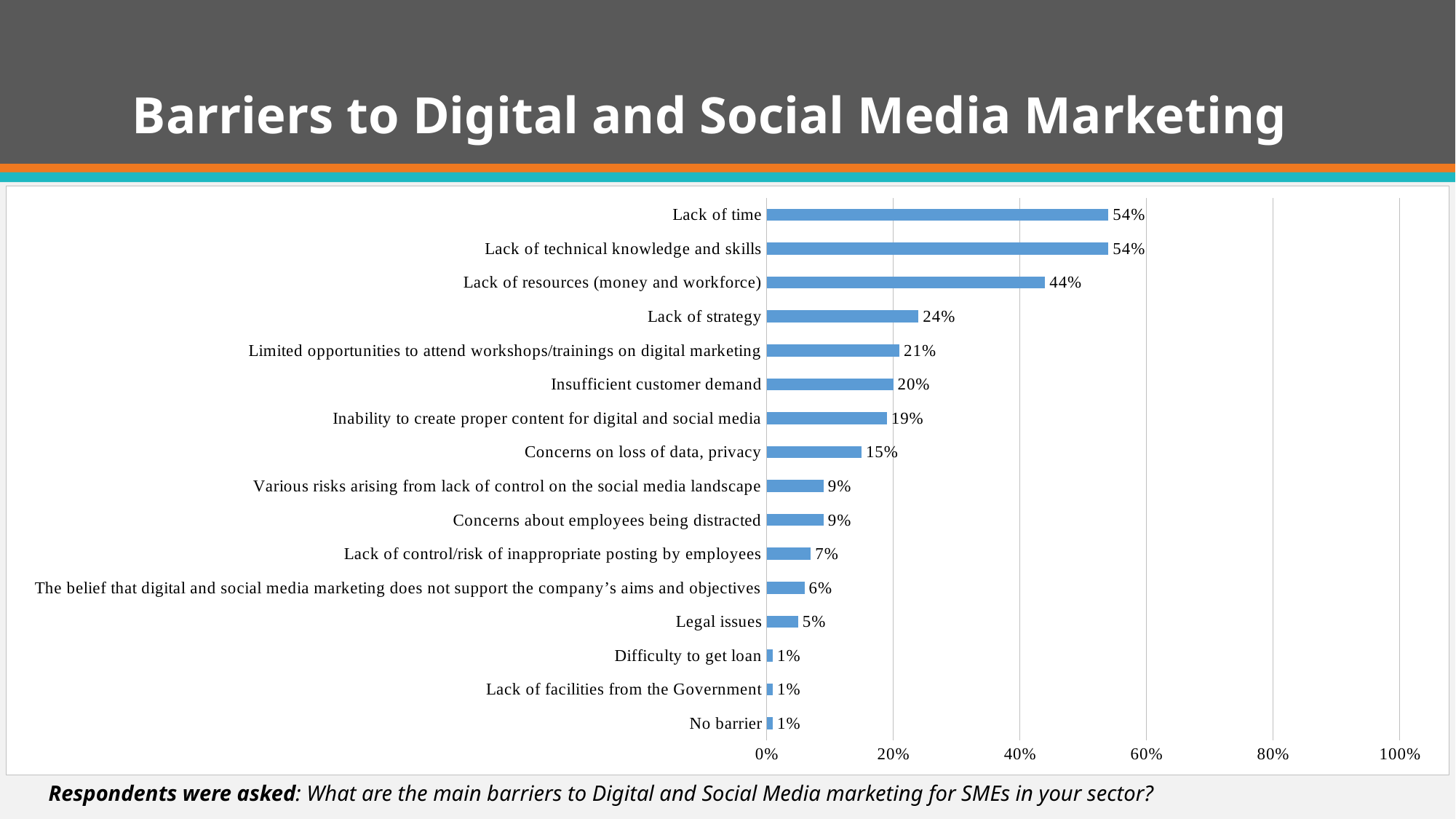
What percentage of respondents cited Lack of resources (money and workforce) as a barrier? 44% Is the value for Lack of resources (money and workforce) greater or less than 40%? greater What is the difference between Lack of strategy and Insufficient customer demand? 4% Which is larger: Insufficient customer demand or Inability to create proper content for digital and social media? Insufficient customer demand What kind of chart is shown on the slide? Bar chart What percentage is shown for Concerns on loss of data, privacy? 15% What is the value for Lack of strategy? 24% How many barrier categories are plotted in the chart? 16 What is the title of the slide containing the chart? Barriers to Digital and Social Media Marketing What is the difference between the values for Lack of time and Lack of resources (money and workforce)? 10% Which barrier has the lowest value among Legal issues, Lack of strategy and Insufficient customer demand? Legal issues What is the value for Legal issues? 5%